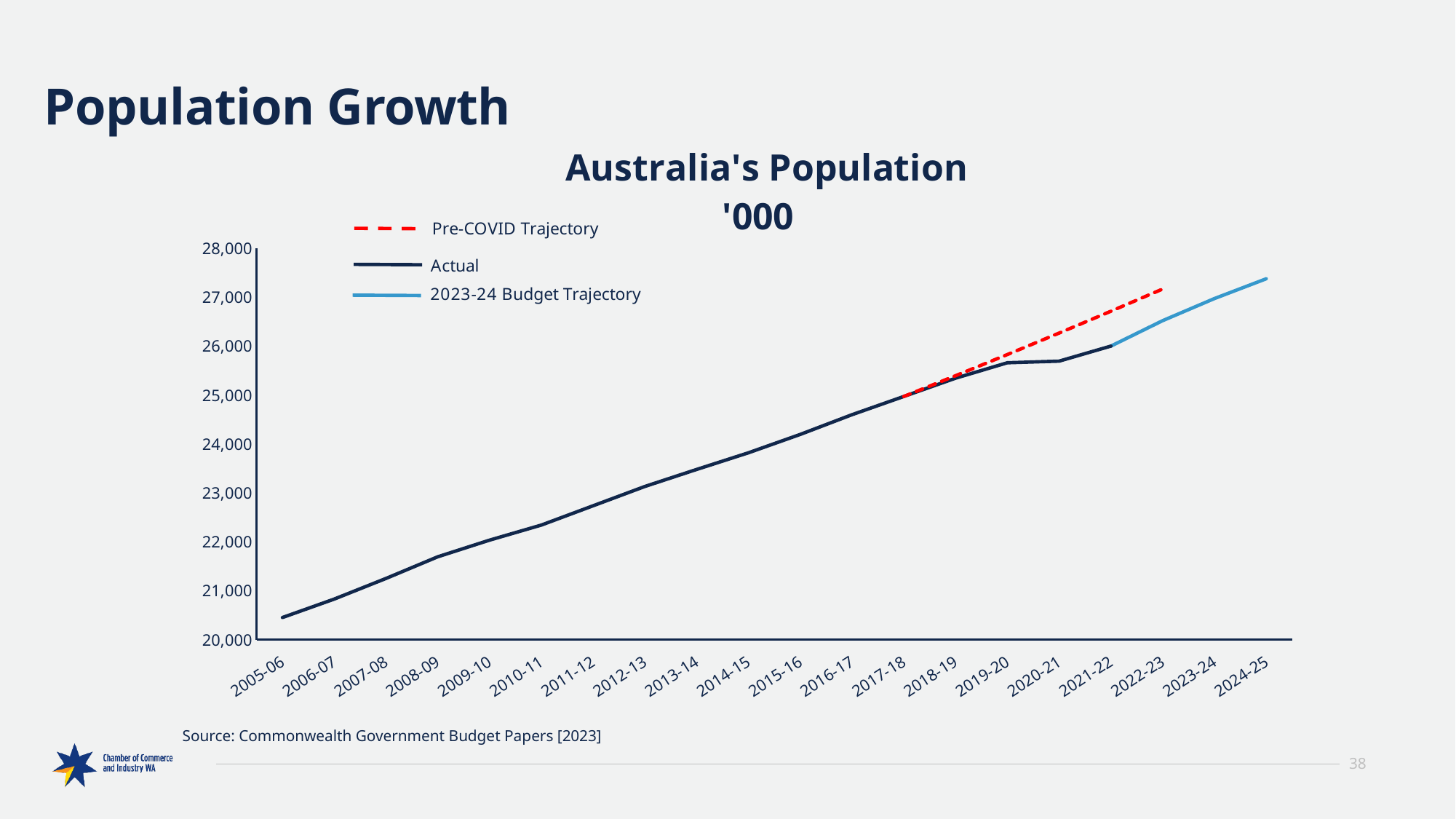
Is the Actual value for 2005-06 greater or less than 21,000? less What is the title of the chart? Australia's Population '000 Is the 2023-24 Budget Trajectory value for 2024-25 greater or less than 27,000? greater How many series does the legend list? 3 How many financial years are shown on the x axis? 20 Is the Actual value for 2014-15 greater or less than 24,000? less Does the Actual series generally rise or fall from 2005-06 to 2021-22? Rise In 2021-22, which is higher: the Pre-COVID Trajectory or the Actual series? Pre-COVID Trajectory What kind of chart is shown on the slide? Line chart Which series is drawn as a red dashed line? Pre-COVID Trajectory